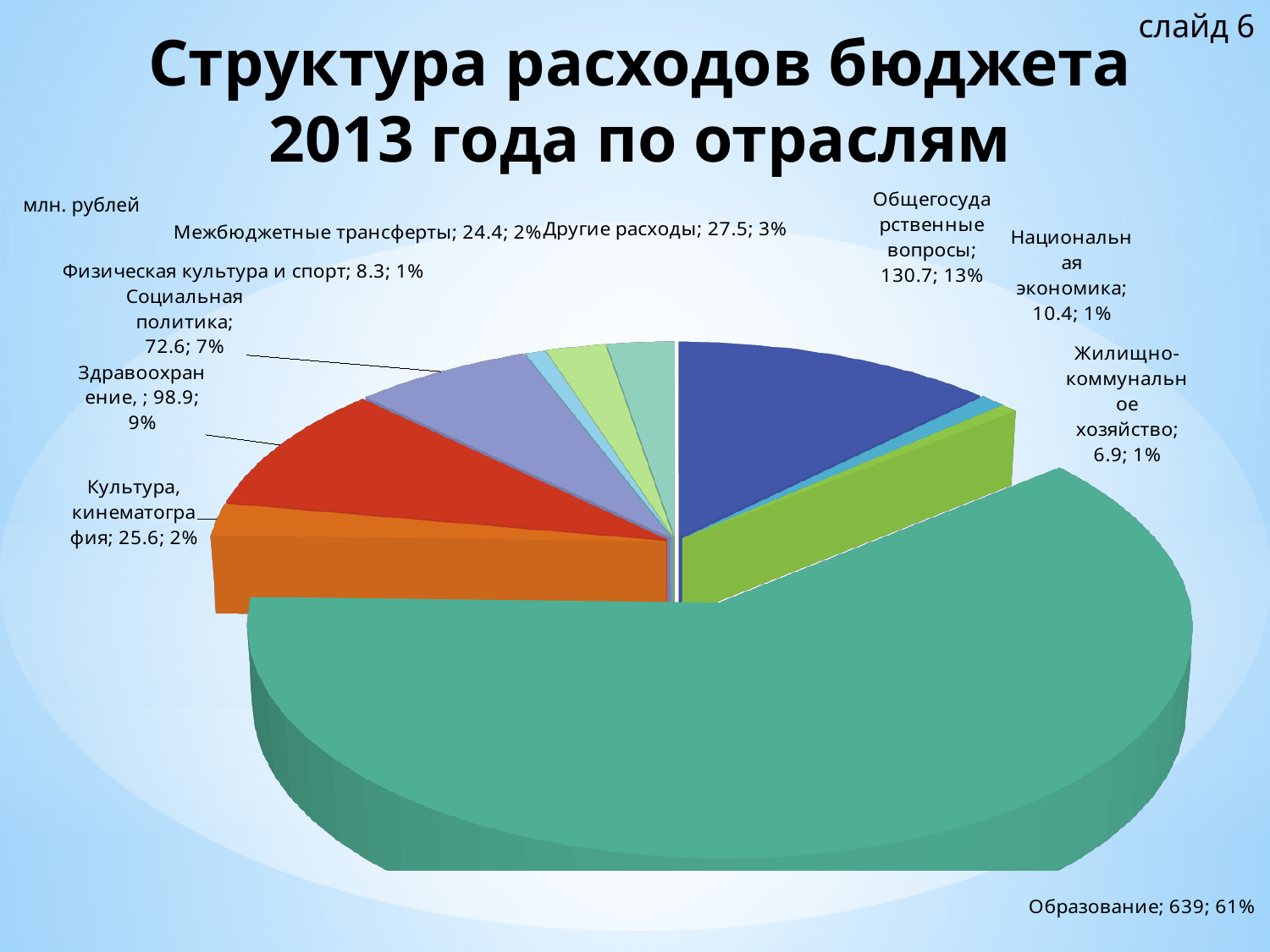
Which category has the smallest value? Жилищно-коммунальное хозяйство What kind of chart is shown on the slide? pie chart What share of the pie does Образование take? 61% What is the value for Общегосударственные вопросы? 130.7 What is the value for Здравоохранение? 98.9 How many categories does the pie chart have? 10 What is the value for Образование? 639 What share of the pie does Социальная политика take? 7% What is the difference between the values for Общегосударственные вопросы and Здравоохранение? 31.8 Which is larger, the value for Другие расходы or the value for Культура, кинематография? Другие расходы Which category has the largest slice? Образование What unit is indicated for the values in the chart? млн. рублей